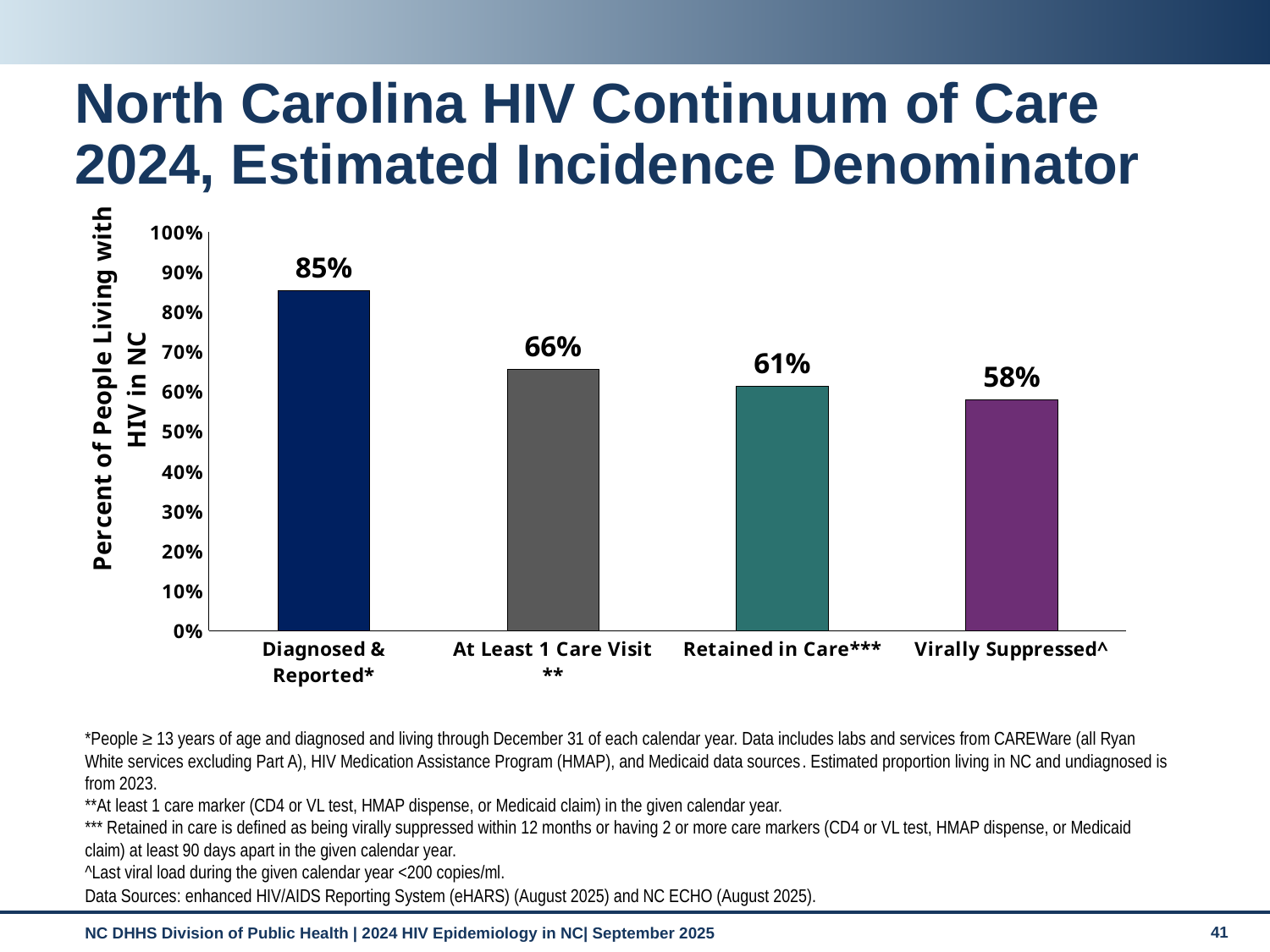
Which category has the highest value? Diagnosed & Reported What is the difference between the Diagnosed & Reported value and the Virally Suppressed value? 27% How many categories are shown on the chart? 4 What kind of chart is shown on the slide? Bar chart What is the value for Retained in Care? 61% What percentage of people living with HIV in NC are Diagnosed & Reported? 85% What is the difference between At Least 1 Care Visit and Retained in Care? 5% What is the value for Virally Suppressed? 58% Which category has the lowest value? Virally Suppressed What is the value for At Least 1 Care Visit? 66% Which is larger, the value for At Least 1 Care Visit or the value for Retained in Care? At Least 1 Care Visit Do the values rise or fall from left to right across the categories? Fall